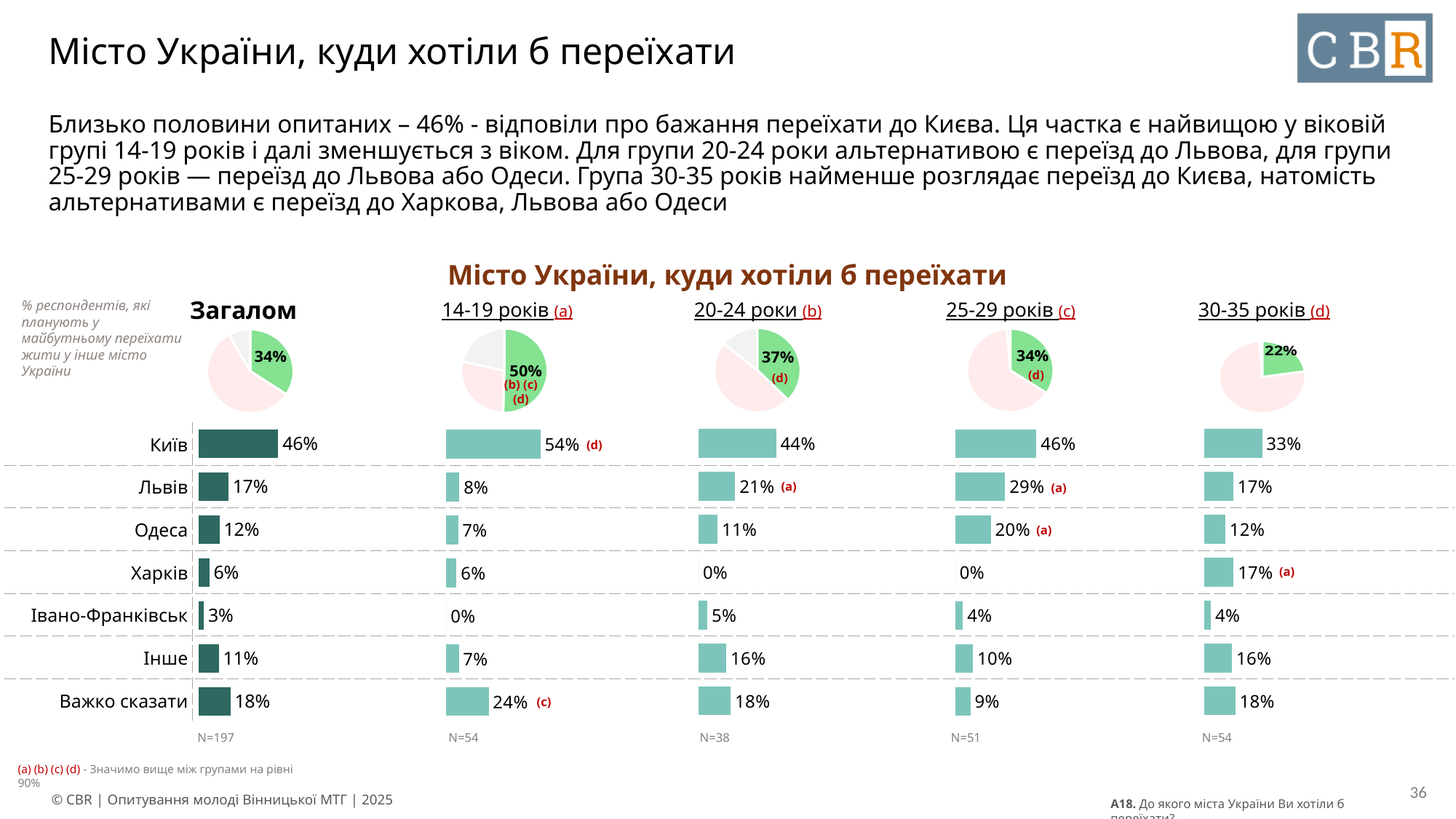
In the '14-19 років (a)' bar chart, what is the value for Важко сказати? 24% What is the title of the chart section on the slide? Місто України, куди хотіли б переїхати In the 'Загалом' bar chart, what is the value for Київ? 46% In the '14-19 років (a)' bar chart, what is the difference between Київ and Львів? 46% In the '30-35 років (d)' bar chart, which city has the highest value? Київ What kind of chart is used for the 'Загалом' group below the pie? bar chart In the '30-35 років (d)' bar chart, which is larger: Київ or Важко сказати? Київ What is the green share shown in the '14-19 років (a)' pie chart? 50% In the '25-29 років (c)' bar chart, what is the value for Львів? 29% How many categories are listed in the 'Загалом' bar chart? 7 In the '20-24 роки (b)' bar chart, which category has the lowest value? Харків What is the green share shown in the '30-35 років (d)' pie chart? 22%